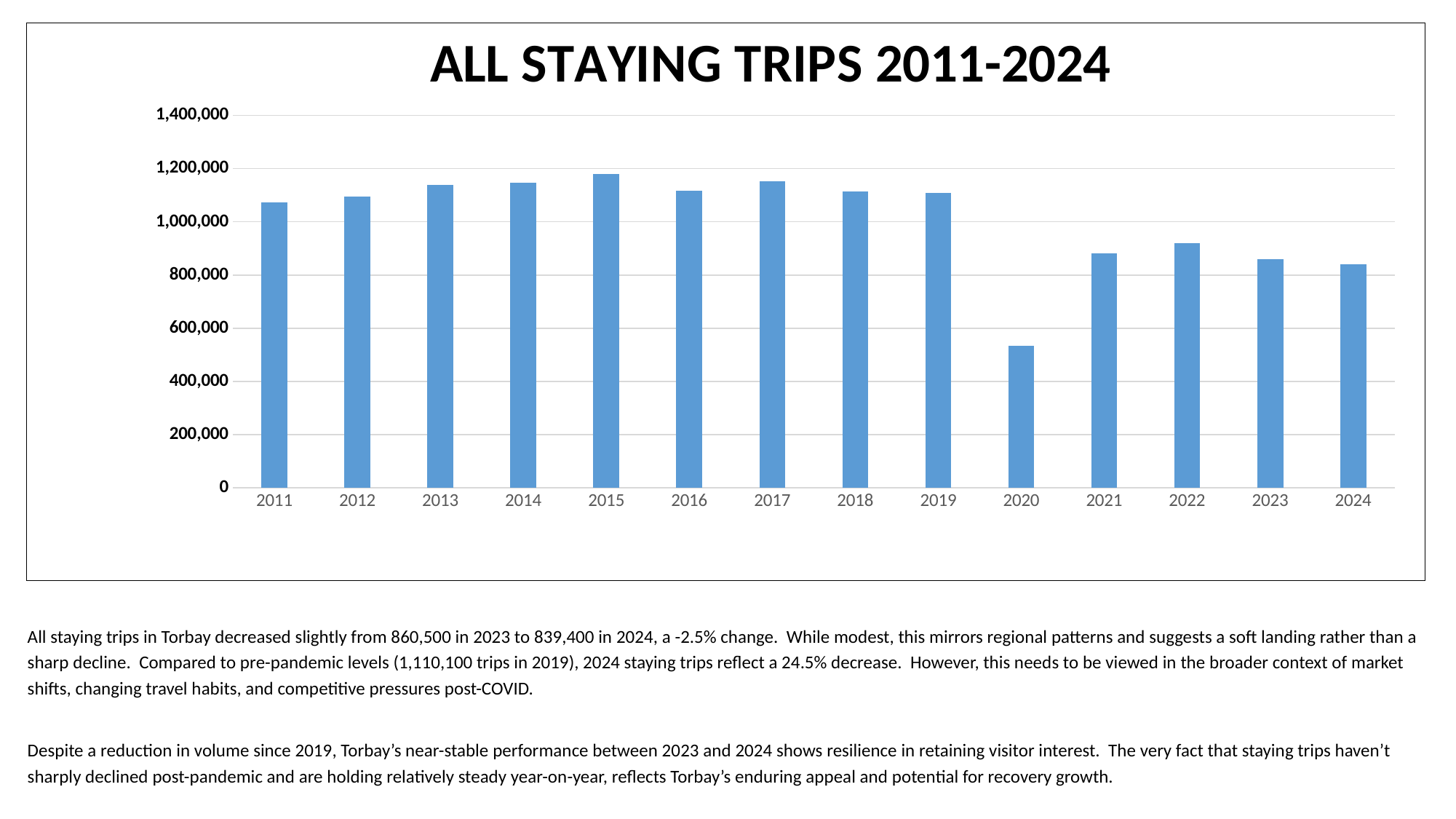
What kind of chart is shown on the slide? bar chart Is the value for 2015 greater or less than 1,200,000? less Which year has the lowest number of staying trips? 2020 Which year has the highest number of staying trips? 2015 Which year has more staying trips, 2020 or 2021? 2021 What is the title of the chart? ALL STAYING TRIPS 2011-2024 How many years are shown on the x axis of the chart? 14 Is the value for 2020 greater or less than 600,000? less Do the values rise or fall from 2022 to 2024? fall Which year has more staying trips, 2022 or 2023? 2022 Is the value for 2011 greater or less than 1,000,000? greater